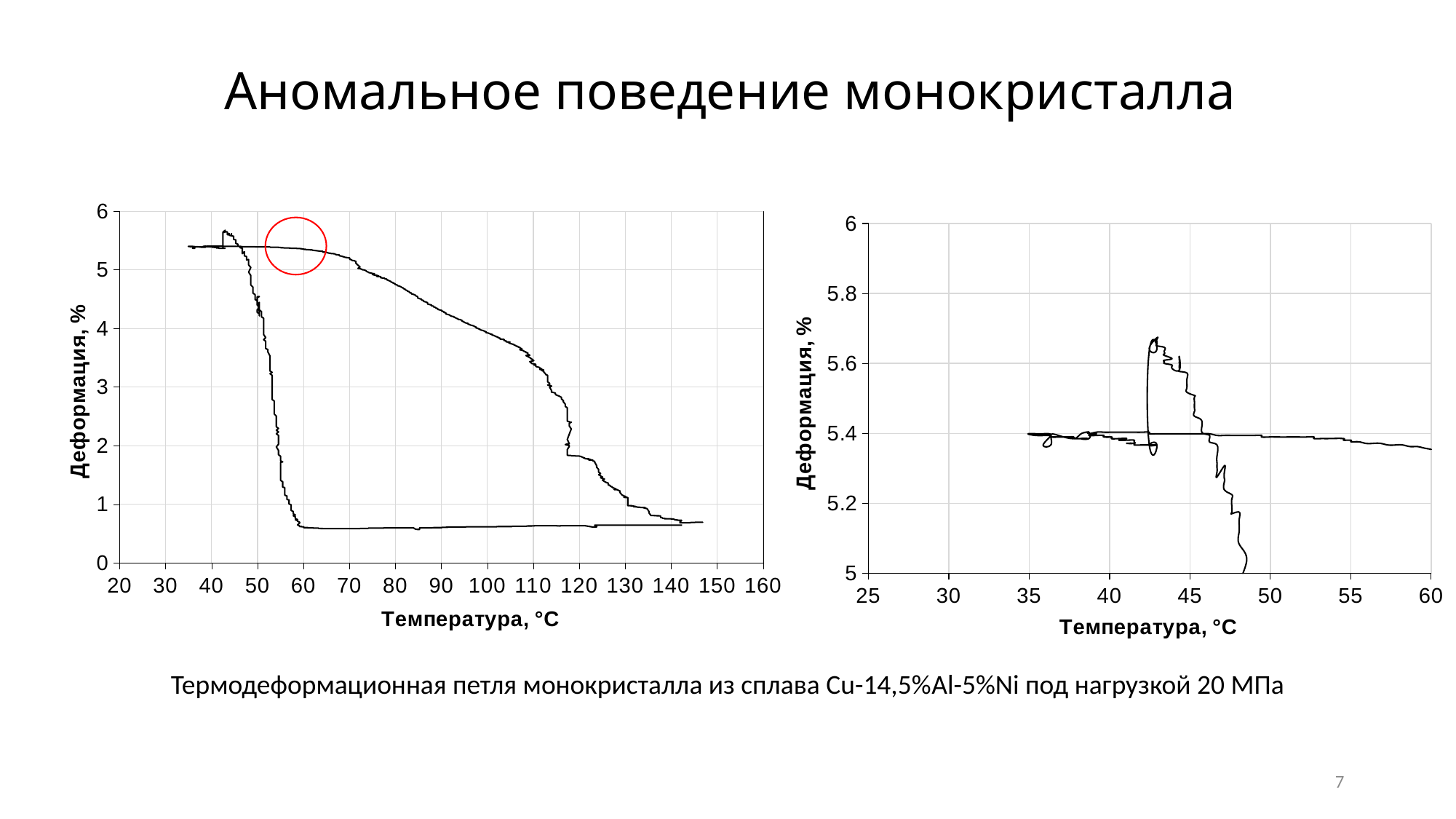
On the right chart, is the deformation value at 55 °C greater or less than 5.2? greater What is the x-axis title of the left chart? Температура, °C What kind of chart is the left chart on the slide? line chart What is the maximum value shown on the x axis of the left chart? 160 On the left chart, does the deformation rise or fall as temperature increases from 70 °C to 120 °C along the upper branch of the curve? fall On the left chart, is the deformation value at 140 °C greater or less than 1? less On the left chart, is the highest deformation value reached by the curve greater or less than 6? less What is the y-axis title of the right chart? Деформация, %